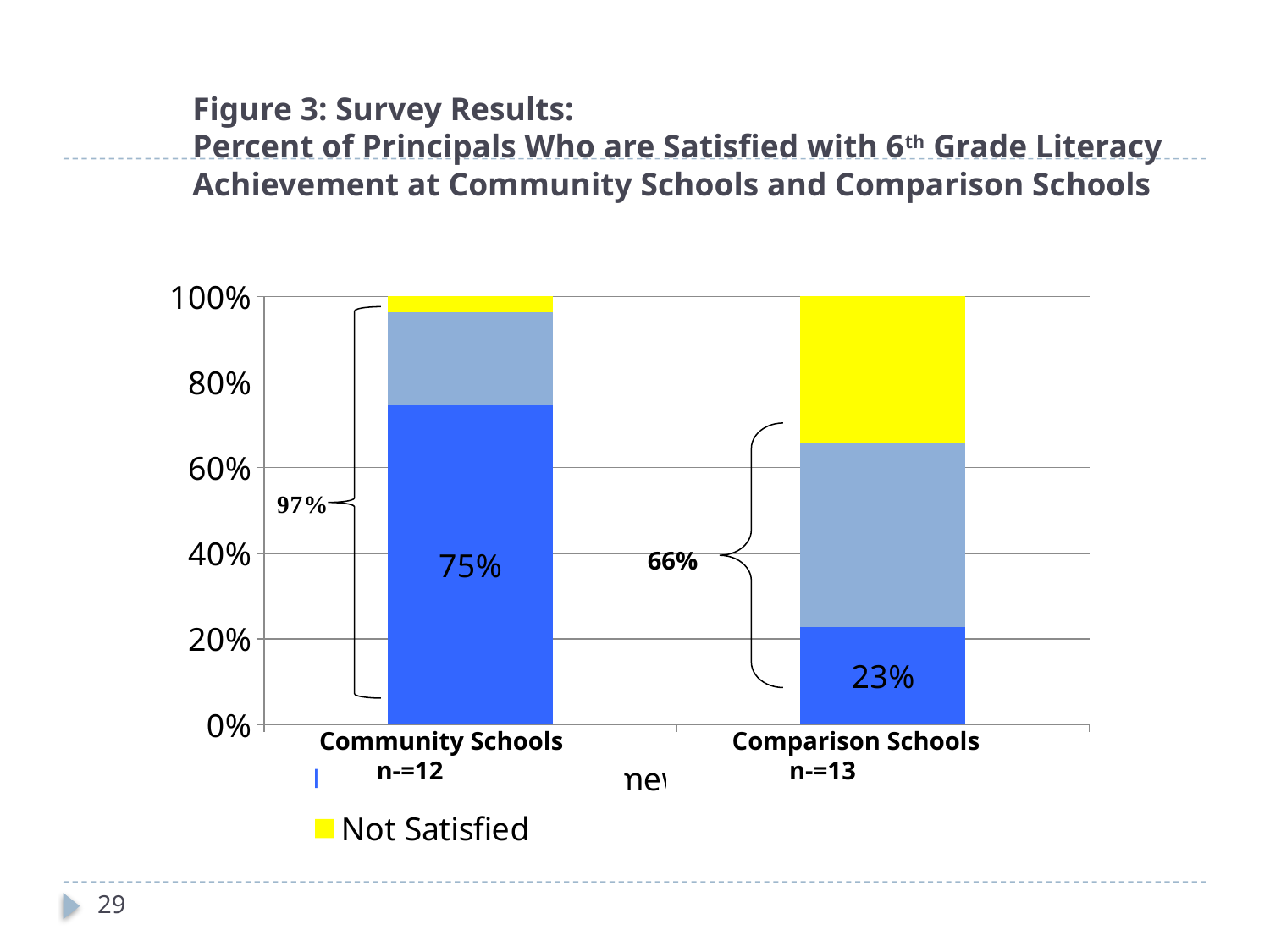
Which category has the larger blue segment, Community Schools or Comparison Schools? Community Schools Which legend entry is shown in yellow? Not Satisfied Is the yellow segment of the Comparison Schools bar greater or less than 20% of the bar? greater How many categories are shown on the x axis of the chart? 2 What percentage is labelled on the blue segment of the Community Schools bar? 75% What percentage is labelled on the blue segment of the Comparison Schools bar? 23% What is the difference between the bracketed values for Community Schools (97%) and Comparison Schools (66%)? 31 percentage points What percentage does the bracket beside the Comparison Schools bar indicate? 66% What is the difference between the blue segment values for Community Schools (75%) and Comparison Schools (23%)? 52 percentage points Which category has the higher bracketed percentage? Community Schools What percentage does the bracket beside the Community Schools bar indicate? 97% What kind of chart is shown on the slide? Stacked bar chart